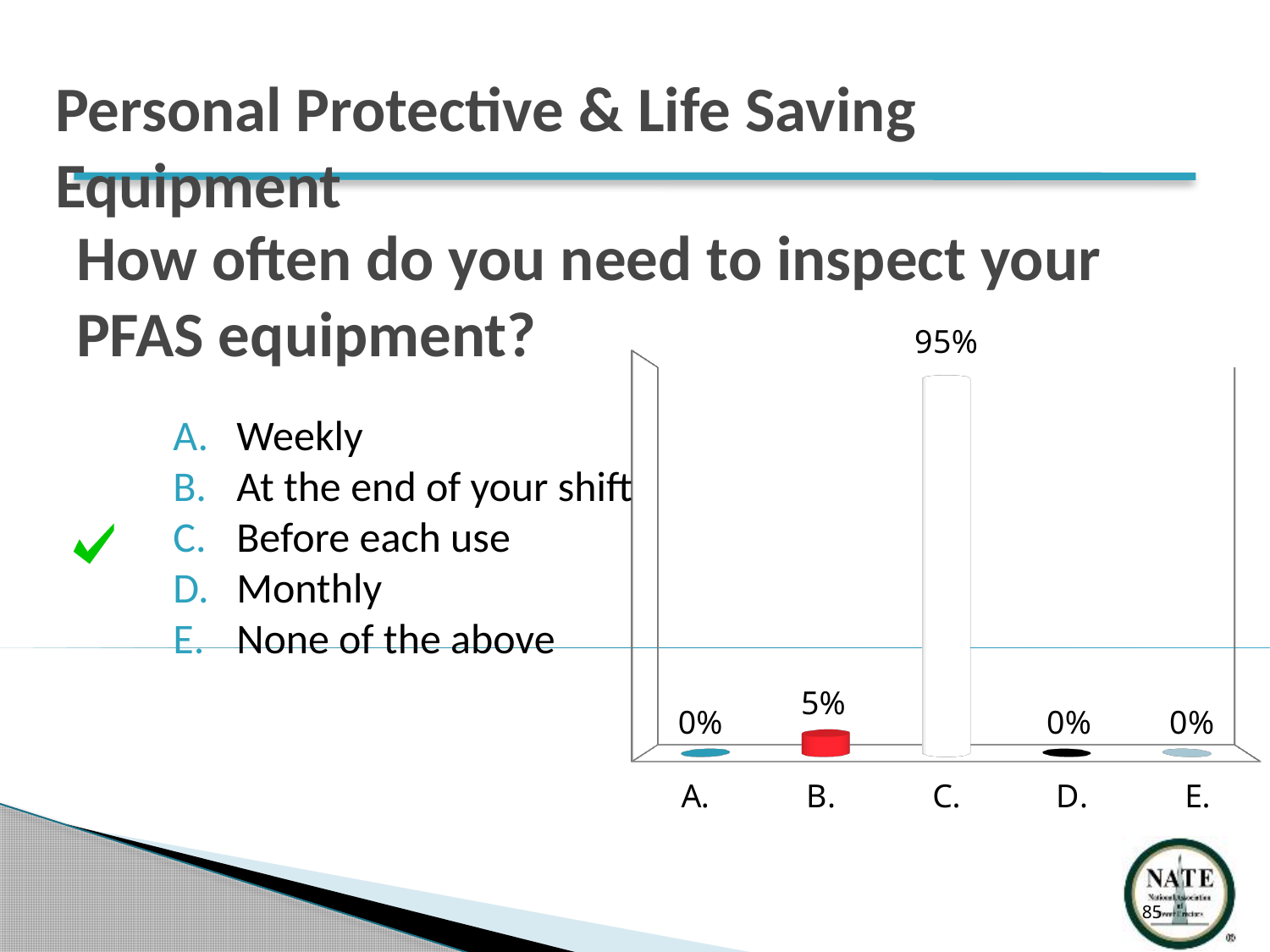
Which category has the highest value? C. How many categories are shown on the x axis? 5 Which is larger, the value for B. or the value for D.? B. What is the value for category A.? 0% What is the value for category B.? 5% What is the value for category E.? 0% What is the total of the values for B. and C.? 100% How many categories have a value of 0%? 3 What colour is the bar for category B.? red What kind of chart is shown? bar chart What is the difference between the values for C. and B.? 90% What is the value for category C.? 95%